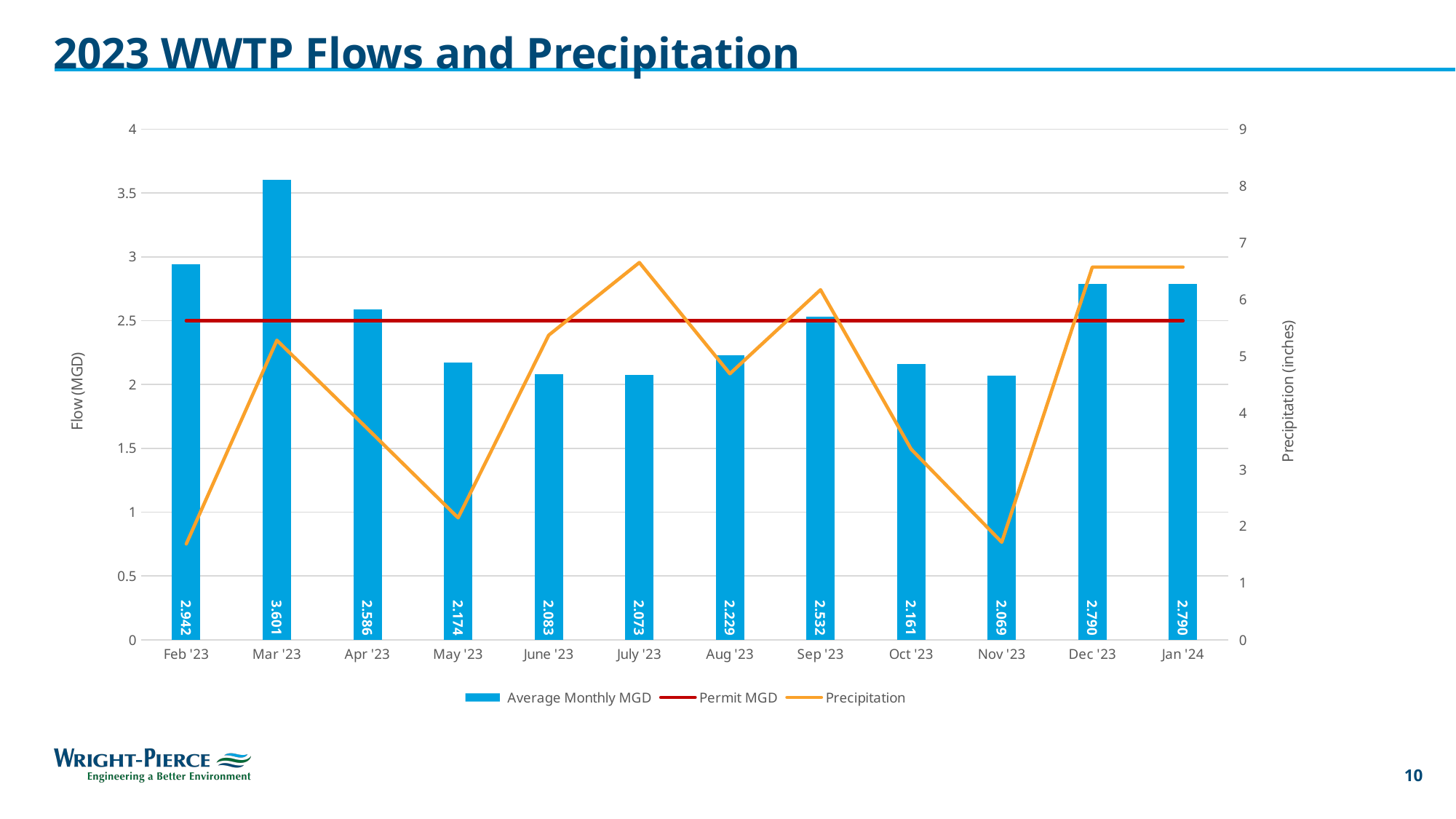
What is the difference in Average Monthly MGD between Mar '23 and Feb '23? 0.659 What is the Average Monthly MGD for Nov '23? 2.069 What is the Average Monthly MGD for Mar '23? 3.601 Is the Precipitation value for July '23 greater or less than 6 inches? greater Is the Precipitation value for Nov '23 greater or less than 2 inches? less How many series does the legend list? 3 How many months are shown on the x axis? 12 At what Flow (MGD) value does the Permit MGD line sit? 2.5 Which month has the lowest Average Monthly MGD? Nov '23 Which has the larger Average Monthly MGD, Apr '23 or Sep '23? Apr '23 Which month has the highest Average Monthly MGD? Mar '23 What is the Average Monthly MGD for Jan '24? 2.790